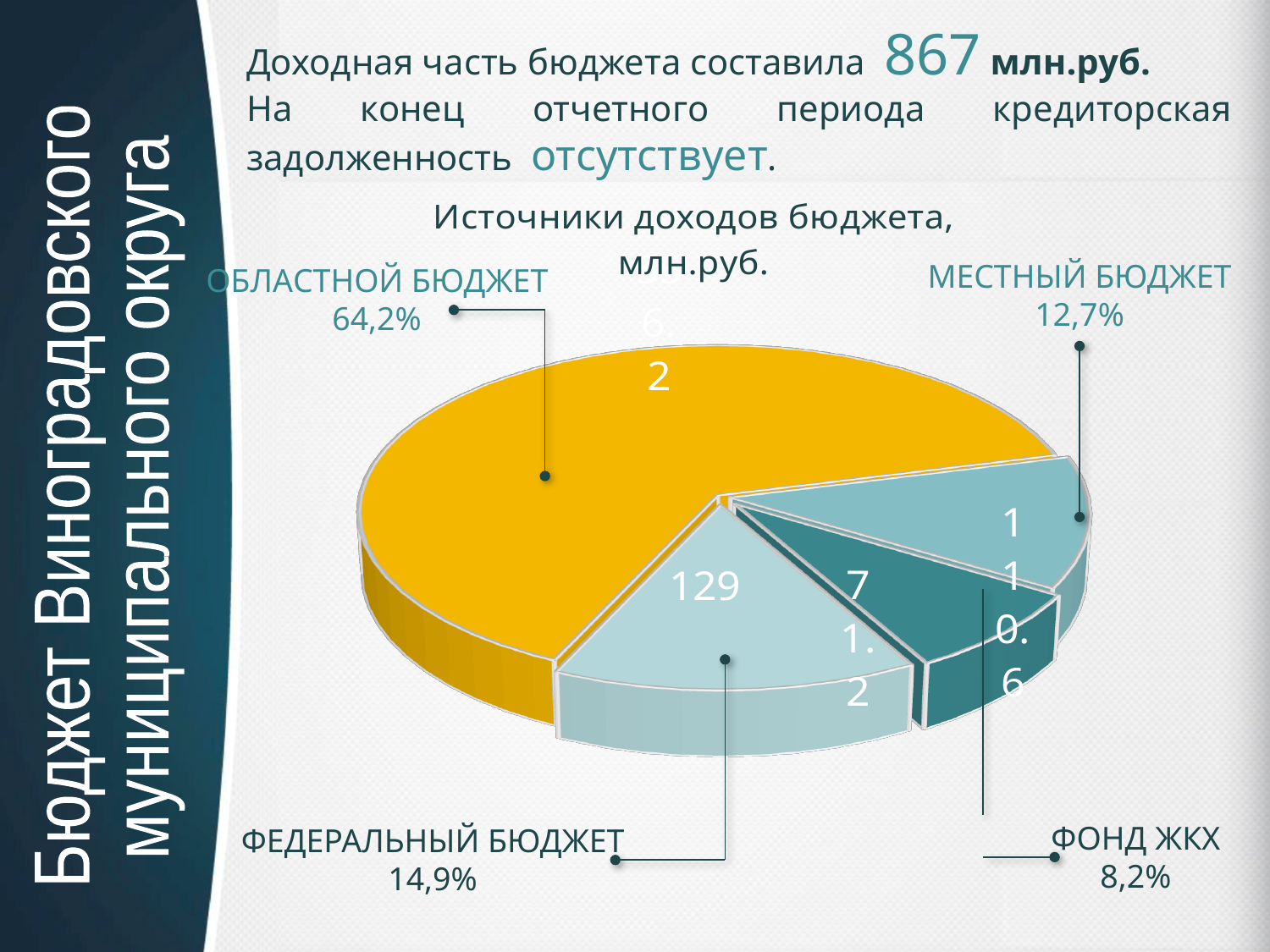
What is the value shown for ФЕДЕРАЛЬНЫЙ БЮДЖЕТ? 129 What share of the pie does МЕСТНЫЙ БЮДЖЕТ represent? 12,7% What share of the pie does ФОНД ЖКХ represent? 8,2% What share of the pie does ОБЛАСТНОЙ БЮДЖЕТ represent? 64,2% What is the title of the chart? Источники доходов бюджета, млн.руб. Which is larger, the share of ФЕДЕРАЛЬНЫЙ БЮДЖЕТ or the share of МЕСТНЫЙ БЮДЖЕТ? ФЕДЕРАЛЬНЫЙ БЮДЖЕТ What kind of chart is shown on the slide? pie chart Which source of budget income has the largest slice? ОБЛАСТНОЙ БЮДЖЕТ Which source of budget income has the smallest slice? ФОНД ЖКХ How many slices does the pie chart have? 4 What colour is the slice for ОБЛАСТНОЙ БЮДЖЕТ? yellow